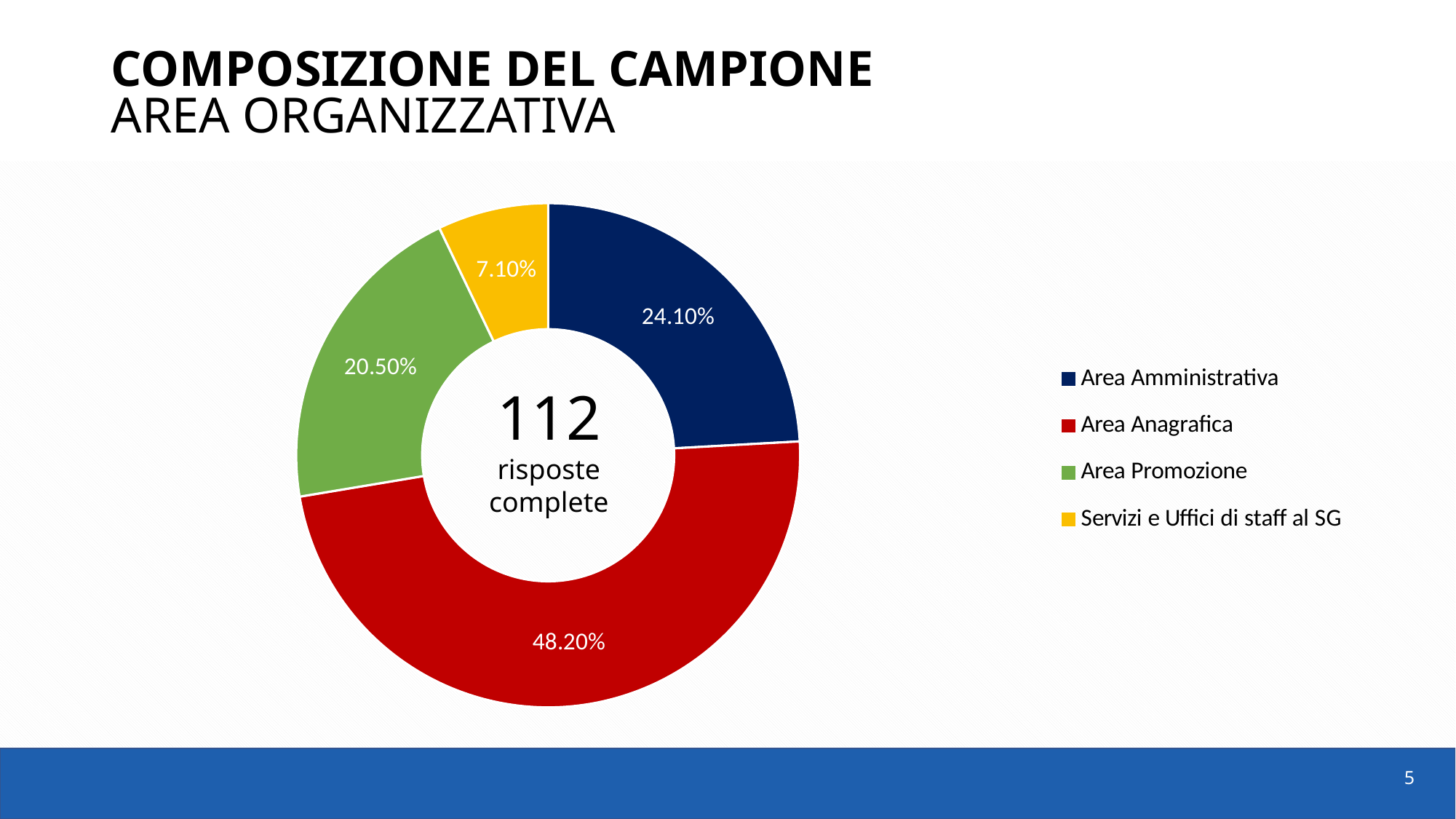
What number is shown in the centre of the chart? 112 What colour represents Area Promozione in the chart? Green Which category has the largest share of the chart? Area Anagrafica What is the difference in percentage points between Area Anagrafica and Area Amministrativa? 24.10 What share of the chart does Area Promozione represent? 20.50% What share of the chart does Servizi e Uffici di staff al SG represent? 7.10% What share of the chart does Area Anagrafica represent? 48.20% What kind of chart is shown on the slide? Doughnut chart Which category has the smallest share of the chart? Servizi e Uffici di staff al SG How many categories are shown in the chart? 4 Which is larger, the share for Area Amministrativa or the share for Area Promozione? Area Amministrativa What share of the chart does Area Amministrativa represent? 24.10%